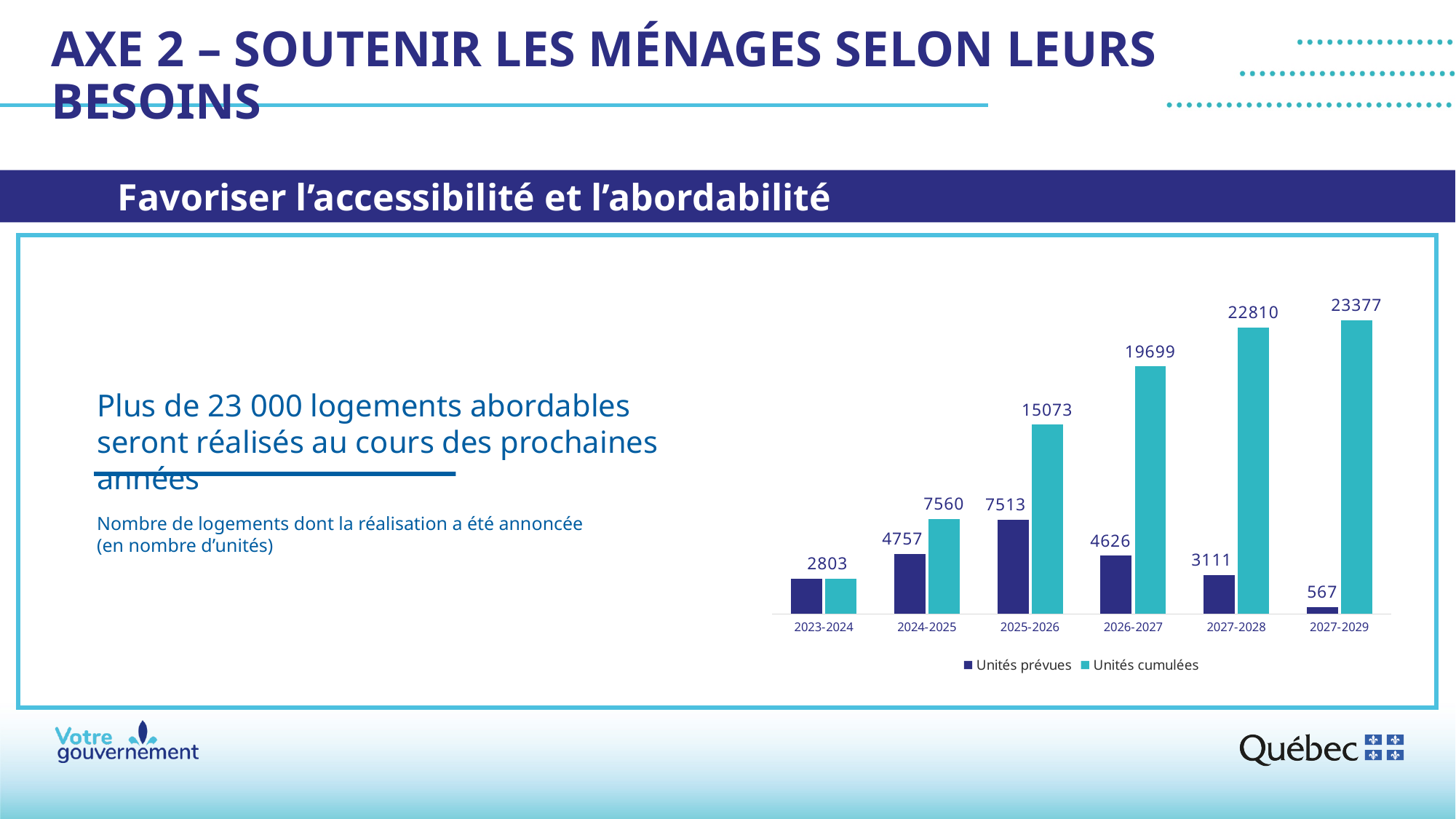
What is the difference between Unités cumulées for 2027-2029 and 2027-2028? 567 What is the value of Unités cumulées for 2026-2027? 19699 Do the values for Unités cumulées rise or fall from 2023-2024 to 2027-2029? Rise What is the value of Unités prévues for 2025-2026? 7513 What is the value of Unités prévues for 2027-2029? 567 Which period has the highest value for Unités prévues? 2025-2026 What is the value of Unités cumulées for 2027-2029? 23377 Which is larger: Unités prévues for 2024-2025 or for 2026-2027? 2024-2025 How many series does the chart legend list? 2 What kind of chart is shown on the slide? Bar chart How many periods are shown on the x axis of the chart? 6 Which period has the lowest value for Unités prévues? 2027-2029